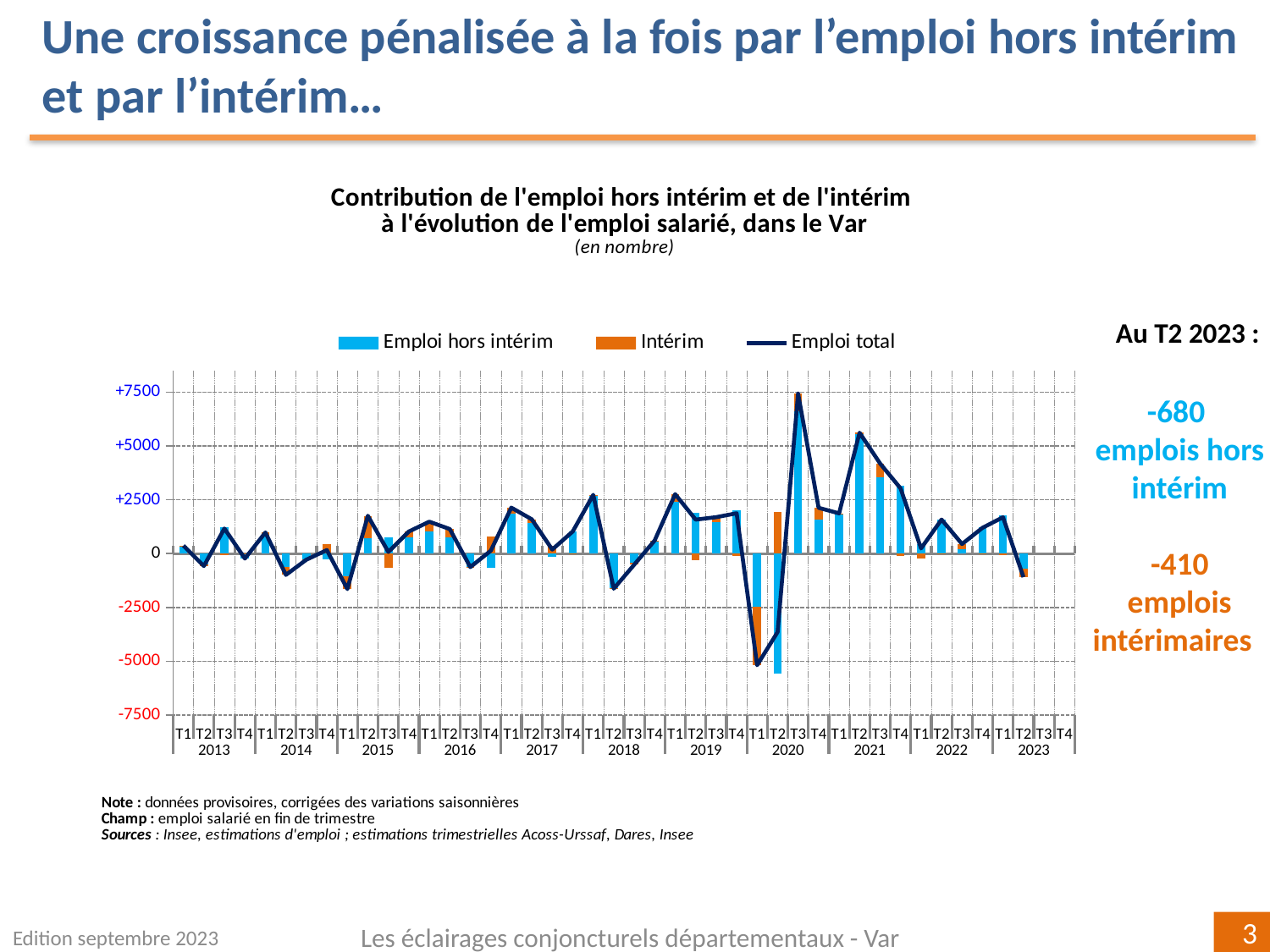
According to the slide, what is the value for Emploi hors intérim at T2 2023? -680 How many series does the chart legend list? 3 In which quarter does the Emploi total line reach its lowest value? T1 2020 Which is larger, the Emploi total at T2 2021 or at T1 2019? T2 2021 According to the slide, what is the value for Intérim at T2 2023? -410 Is the value of Emploi total at T1 2020 greater or less than -2500? less What colour represents the Intérim series in the chart? Orange Is the value of Emploi total at T3 2020 greater or less than +5000? greater In which quarter does the Emploi total line reach its highest value? T3 2020 Is the value of Emploi hors intérim at T2 2020 greater or less than -5000? less What is the combined contribution of Emploi hors intérim and Intérim at T2 2023? -1090 What kind of chart is shown on the slide? A combined bar and line chart